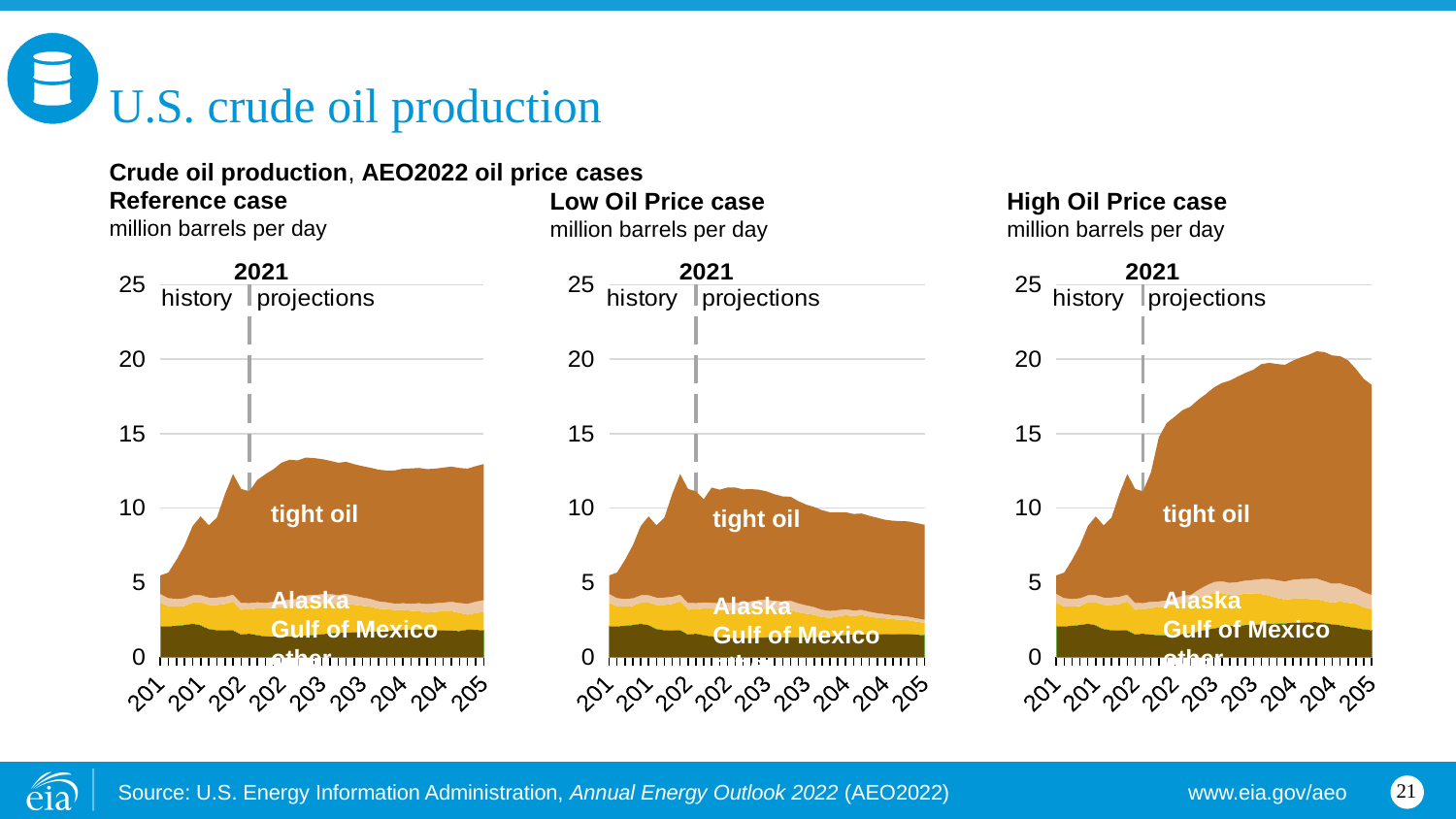
What unit is used on the y axis of the three charts? million barrels per day Which series makes up the largest share of production in all three charts? tight oil In the High Oil Price case chart, is the total crude oil production in the final projection year greater or less than 15? greater Which of the three cases shows the lowest total crude oil production at the end of the projection period? Low Oil Price case In the High Oil Price case chart, does total crude oil production rise or fall over most of the projection period? rise In the Reference case chart, is the total crude oil production in the final projection year greater or less than 10? greater In the Low Oil Price case chart, does total crude oil production rise or fall over the projection period? fall In the Low Oil Price case chart, is the total crude oil production in the final projection year greater or less than 10? less How many charts are shown on the slide? 3 Which of the three cases shows the highest total crude oil production at the end of the projection period? High Oil Price case What kind of chart is used for the Reference case? area chart